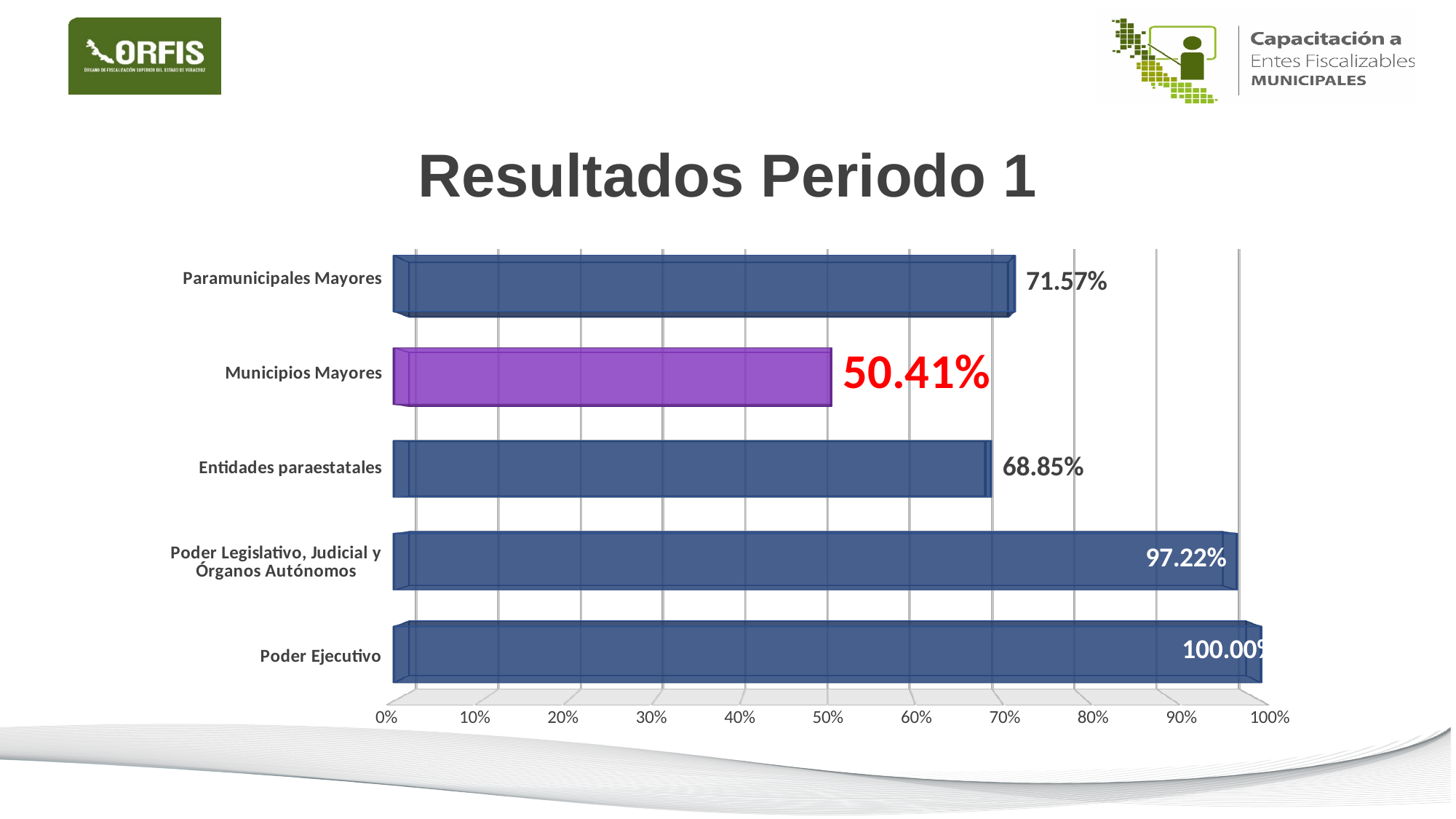
What is the value for Paramunicipales Mayores? 71.57% What is the difference between the values for Poder Legislativo, Judicial y Órganos Autónomos and Municipios Mayores? 46.81% What kind of chart is shown on the slide? Bar chart What is the difference between the values for Paramunicipales Mayores and Entidades paraestatales? 2.72% What is the value for Entidades paraestatales? 68.85% Which is larger, the value for Paramunicipales Mayores or the value for Entidades paraestatales? Paramunicipales Mayores Which category's bar is coloured purple instead of blue? Municipios Mayores What is the value for Poder Legislativo, Judicial y Órganos Autónomos? 97.22% Which category has the highest value? Poder Ejecutivo How many categories are shown in the chart? 5 What is the value for Municipios Mayores? 50.41% Which category has the lowest value? Municipios Mayores